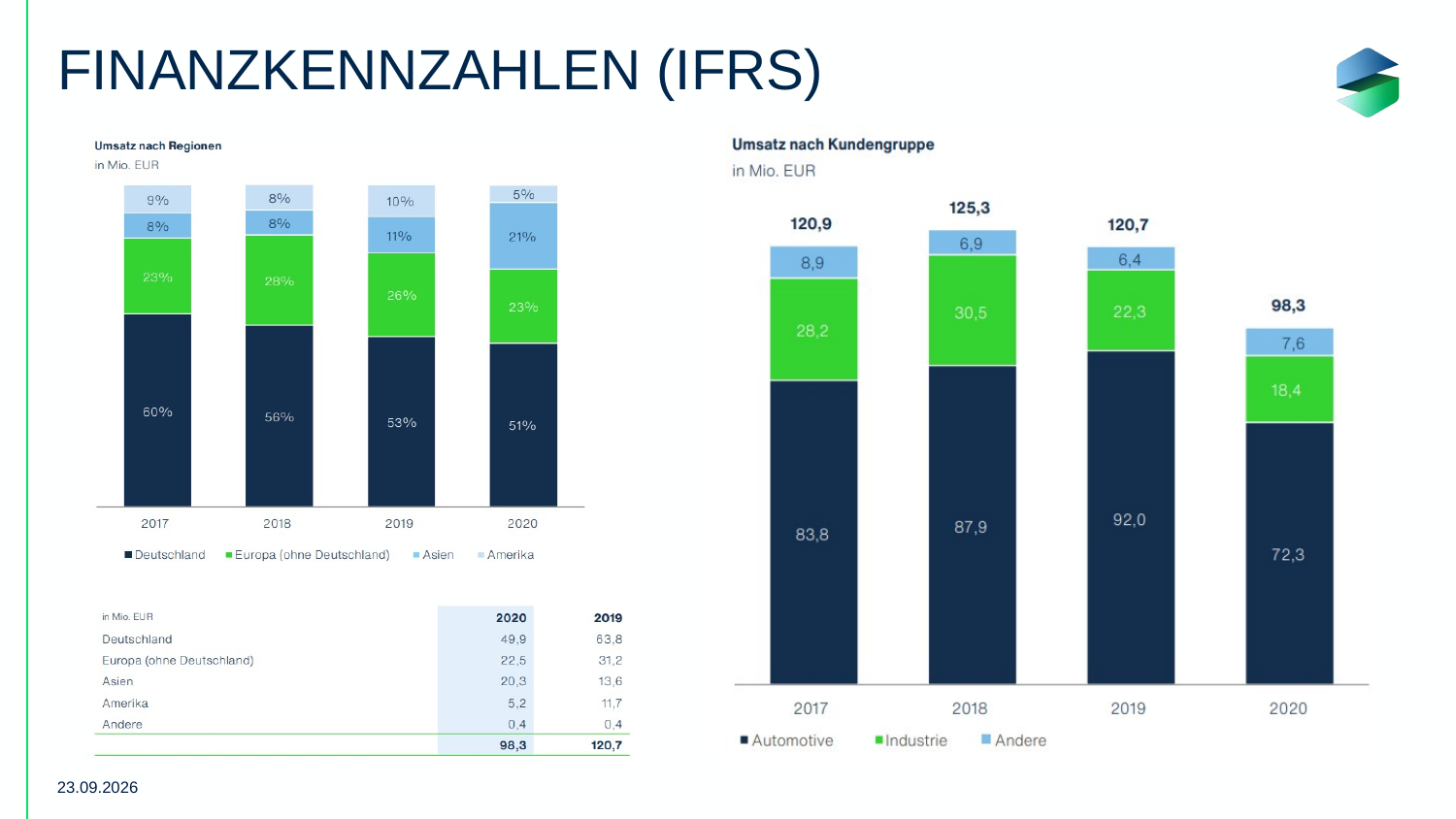
In the 'Umsatz nach Regionen' chart, what share does Deutschland have in 2017? 60% In the 'Umsatz nach Kundengruppe' chart, what is the difference between the Automotive values for 2019 and 2020? 19,7 In the 'Umsatz nach Kundengruppe' chart, how many series does the legend list? 3 In the 'Umsatz nach Kundengruppe' chart, which year has the highest total? 2018 In the 'Umsatz nach Kundengruppe' chart, which year has the lowest total? 2020 In the 'Umsatz nach Kundengruppe' chart, what is the Automotive value for 2019? 92,0 In the 'Umsatz nach Kundengruppe' chart, what is the Industrie value for 2018? 30,5 In the 'Umsatz nach Regionen' chart, how many years are shown on the x axis? 4 In the 'Umsatz nach Kundengruppe' chart, what is the total for 2020? 98,3 In the 'Umsatz nach Regionen' chart, does the Deutschland share rise or fall from 2017 to 2020? fall In the 'Umsatz nach Regionen' chart, what share does Asien have in 2020? 21% What kind of chart is 'Umsatz nach Kundengruppe'? stacked bar chart